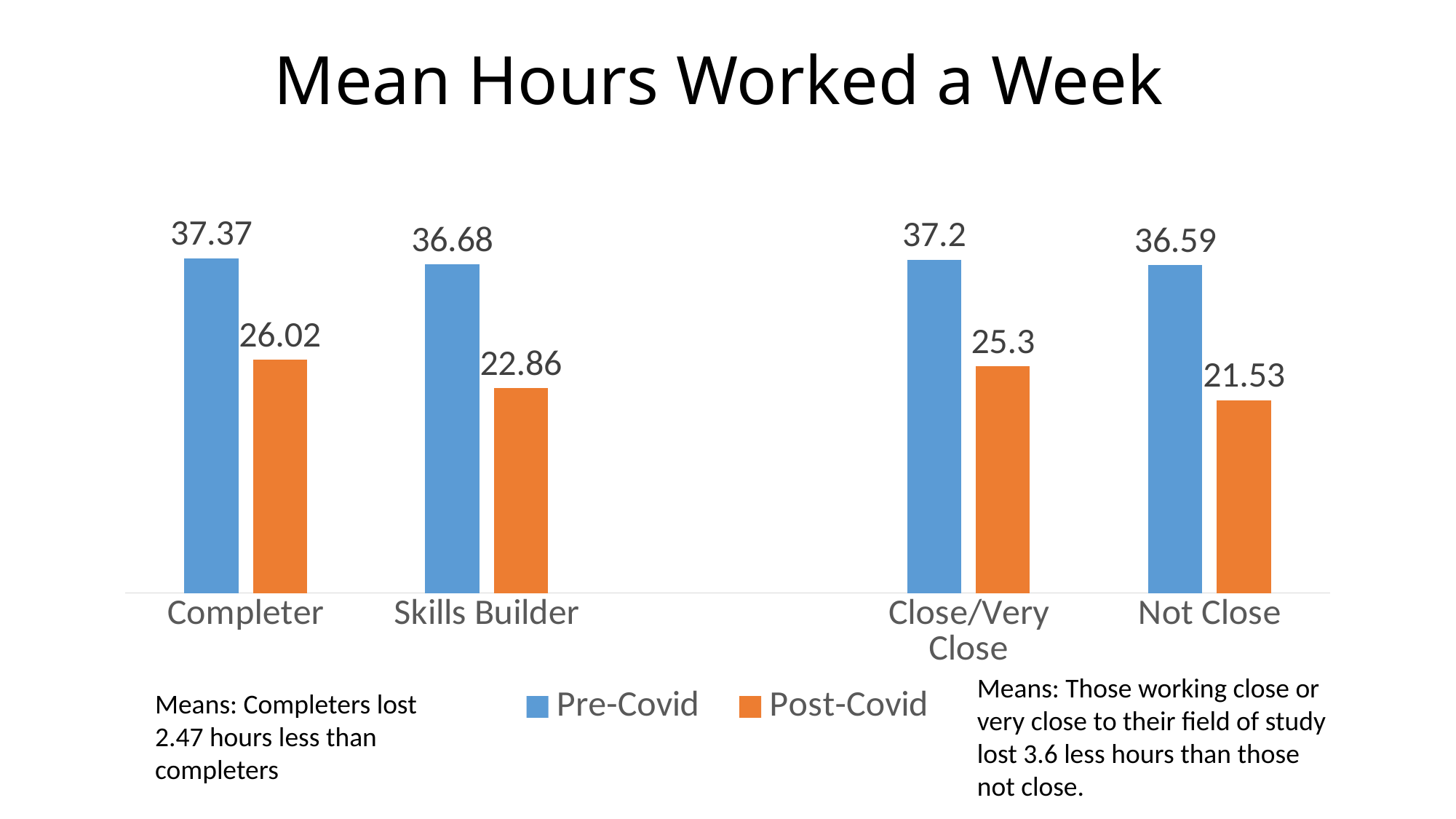
Which is larger, the Post-Covid value for Completer or the Post-Covid value for Skills Builder? Completer What is the Pre-Covid value for Close/Very Close? 37.2 What is the difference between the Pre-Covid and Post-Covid values for Completer? 11.35 What type of chart is shown on the slide? Bar chart How many series does the legend list? 2 How many categories are shown on the x axis? 4 What is the Pre-Covid value for Completer? 37.37 Which category has the highest Pre-Covid value? Completer What is the difference between the Pre-Covid and Post-Covid values for Not Close? 15.06 What is the Post-Covid value for Skills Builder? 22.86 What is the Post-Covid value for Not Close? 21.53 Which category has the lowest Post-Covid value? Not Close